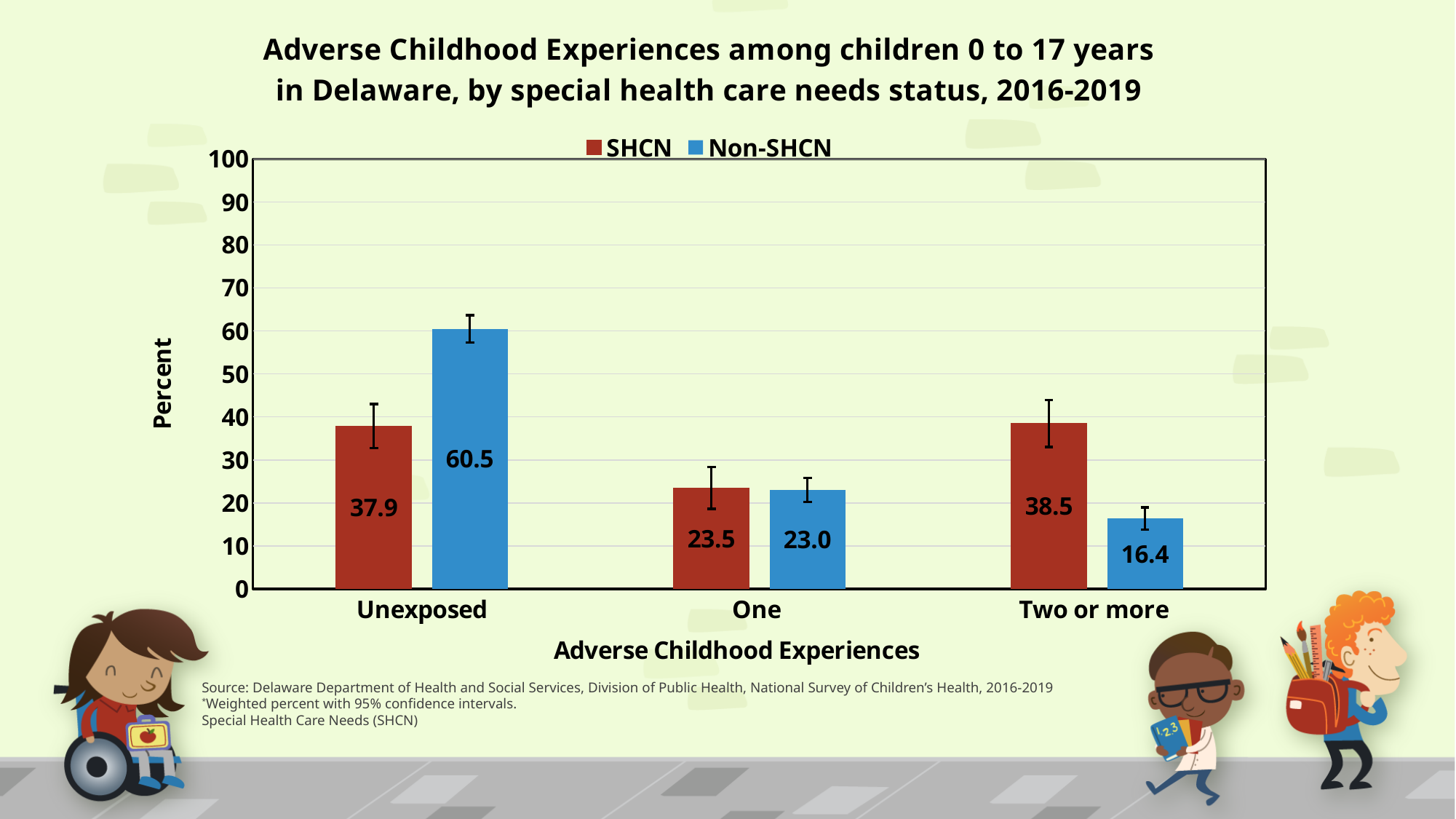
What is the SHCN value for Unexposed? 37.9 What is the Non-SHCN value for Two or more adverse childhood experiences? 16.4 Which category has the highest Non-SHCN value? Unexposed What is the difference between the SHCN and Non-SHCN values for Two or more? 22.1 What is the Non-SHCN value for One adverse childhood experience? 23.0 How many series does the legend list? 2 Which category has the lowest SHCN value? One Is the Non-SHCN value for Unexposed greater or less than 50? greater What kind of chart is shown on the slide? bar chart For Two or more adverse childhood experiences, which series has the larger value, SHCN or Non-SHCN? SHCN How many categories are shown on the x axis? 3 What is the difference between the Non-SHCN and SHCN values for Unexposed? 22.6